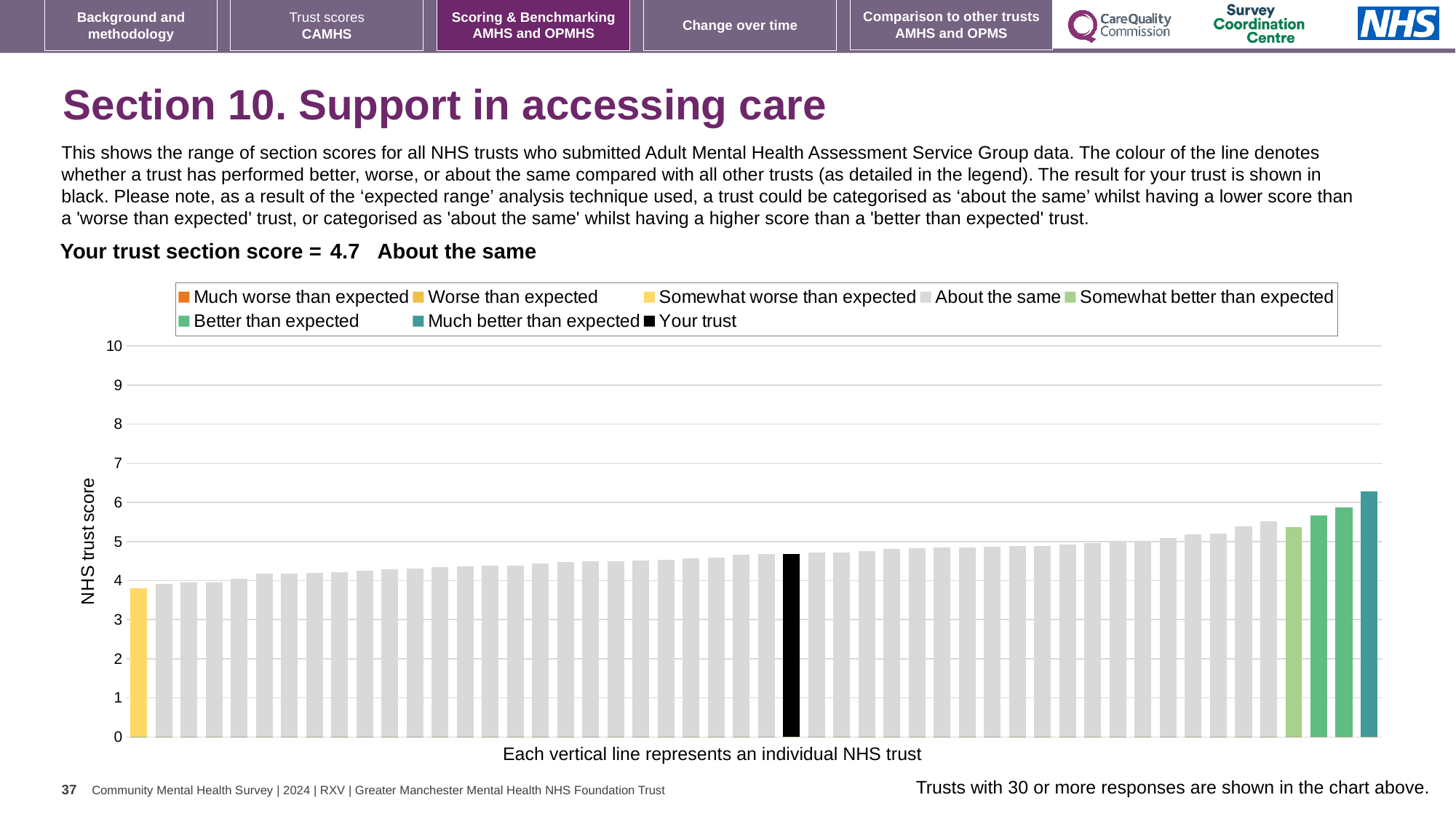
How many entries does the chart legend list? 8 Is the value of the shortest bar in the chart greater or less than 4? less What is the label on the vertical axis of the chart? NHS trust score Which legend category does the leftmost (lowest) bar belong to, based on its colour? Somewhat worse than expected Do the bar values rise or fall from left to right across the chart? Rise What is the section score for your trust shown on the slide? 4.7 What does each vertical line in the chart represent, according to the axis label? An individual NHS trust Is the value of the rightmost bar greater or less than 7? less How is your trust's section score categorised compared with other trusts? About the same Is the value of the tallest bar in the chart greater or less than 6? greater What type of chart is shown on the slide? Bar chart